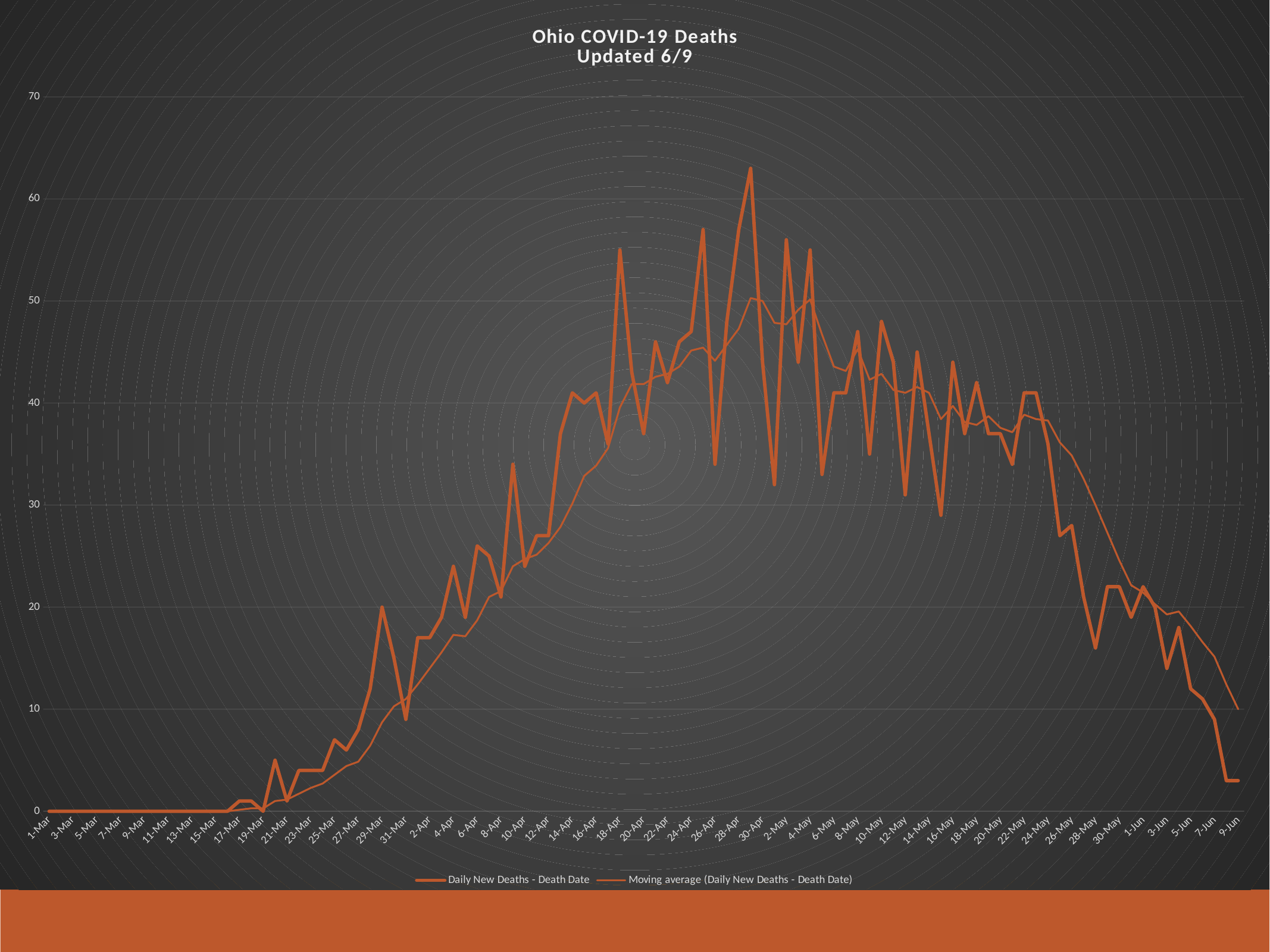
What are the two series named in the legend? Daily New Deaths - Death Date; Moving average (Daily New Deaths - Death Date) How many series does the legend list? 2 Is the value of Daily New Deaths - Death Date on 9-Jun greater or less than 10? less Is the highest value of Daily New Deaths - Death Date greater or less than 60? greater Is the value of Daily New Deaths - Death Date on 28-May greater or less than 20? less What kind of chart is shown on the slide? line chart Do the Daily New Deaths - Death Date values rise or fall from 24-May to 9-Jun? fall On 9-Jun, which is larger: Daily New Deaths - Death Date or the Moving average? Moving average What is the value of Daily New Deaths - Death Date on 1-Mar? 0 Do the Moving average values rise or fall from 17-Mar to 14-Apr? rise What is the title of the chart? Ohio COVID-19 Deaths Updated 6/9